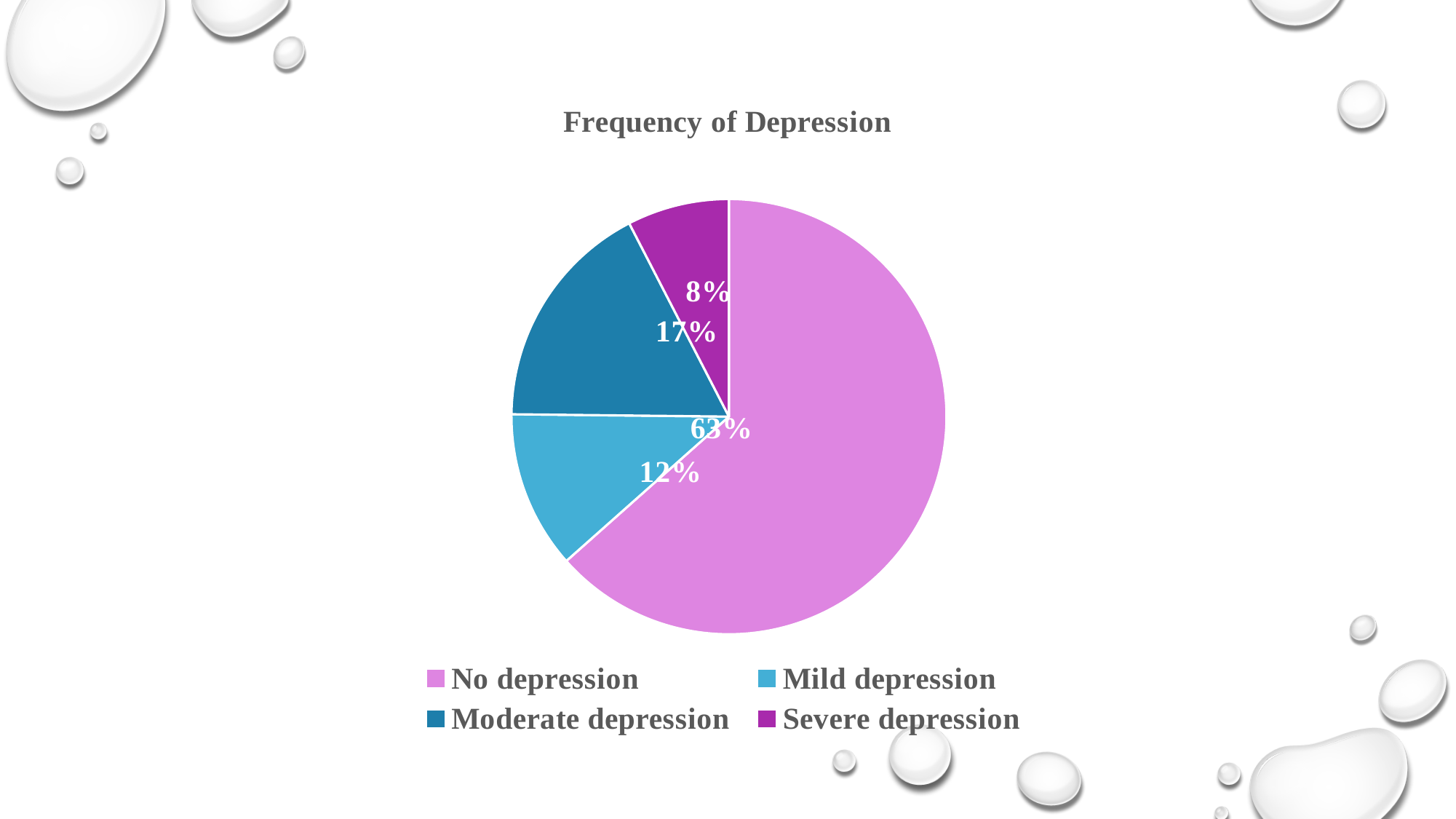
What share of the pie is Moderate depression? 17% Which is larger, the Mild depression slice or the Severe depression slice? Mild depression What type of chart is shown on the slide? pie chart What is the difference between the Moderate depression and Mild depression shares? 5% Which category has the largest slice of the pie? No depression What share of the pie is No depression? 63% Which colour represents Moderate depression in the legend? dark blue What share of the pie is Mild depression? 12% What is the title of the chart? Frequency of Depression What share of the pie is Severe depression? 8% Which category has the smallest slice of the pie? Severe depression How many categories does the pie chart show? 4